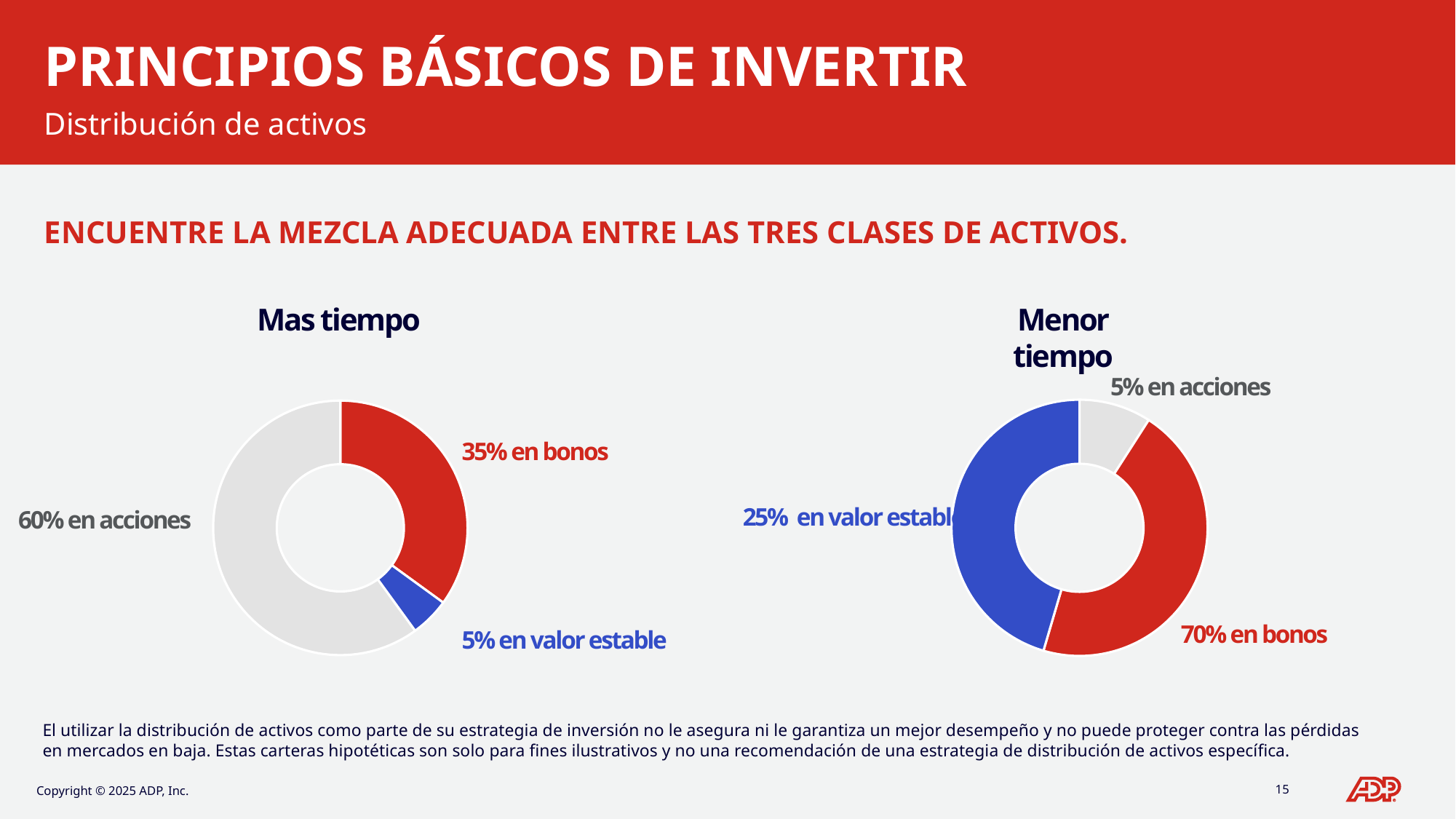
In the 'Mas tiempo' chart, what share is allocated to valor estable? 5% How many asset classes are shown in the 'Mas tiempo' chart? 3 In the 'Menor tiempo' chart, which asset class has the smallest share? acciones In the 'Menor tiempo' chart, what share is allocated to acciones? 5% In the 'Menor tiempo' chart, what share is allocated to valor estable? 25% In the 'Mas tiempo' chart, which asset class has the largest share? acciones In the 'Mas tiempo' chart, what share is allocated to acciones? 60% What is the difference between the bonos share in the 'Menor tiempo' chart and the bonos share in the 'Mas tiempo' chart? 35% In the 'Menor tiempo' chart, what share is allocated to bonos? 70% Which is larger: the valor estable share in the 'Mas tiempo' chart or in the 'Menor tiempo' chart? Menor tiempo In the 'Mas tiempo' chart, what share is allocated to bonos? 35% What type of chart is used for 'Menor tiempo'? Doughnut (pie) chart